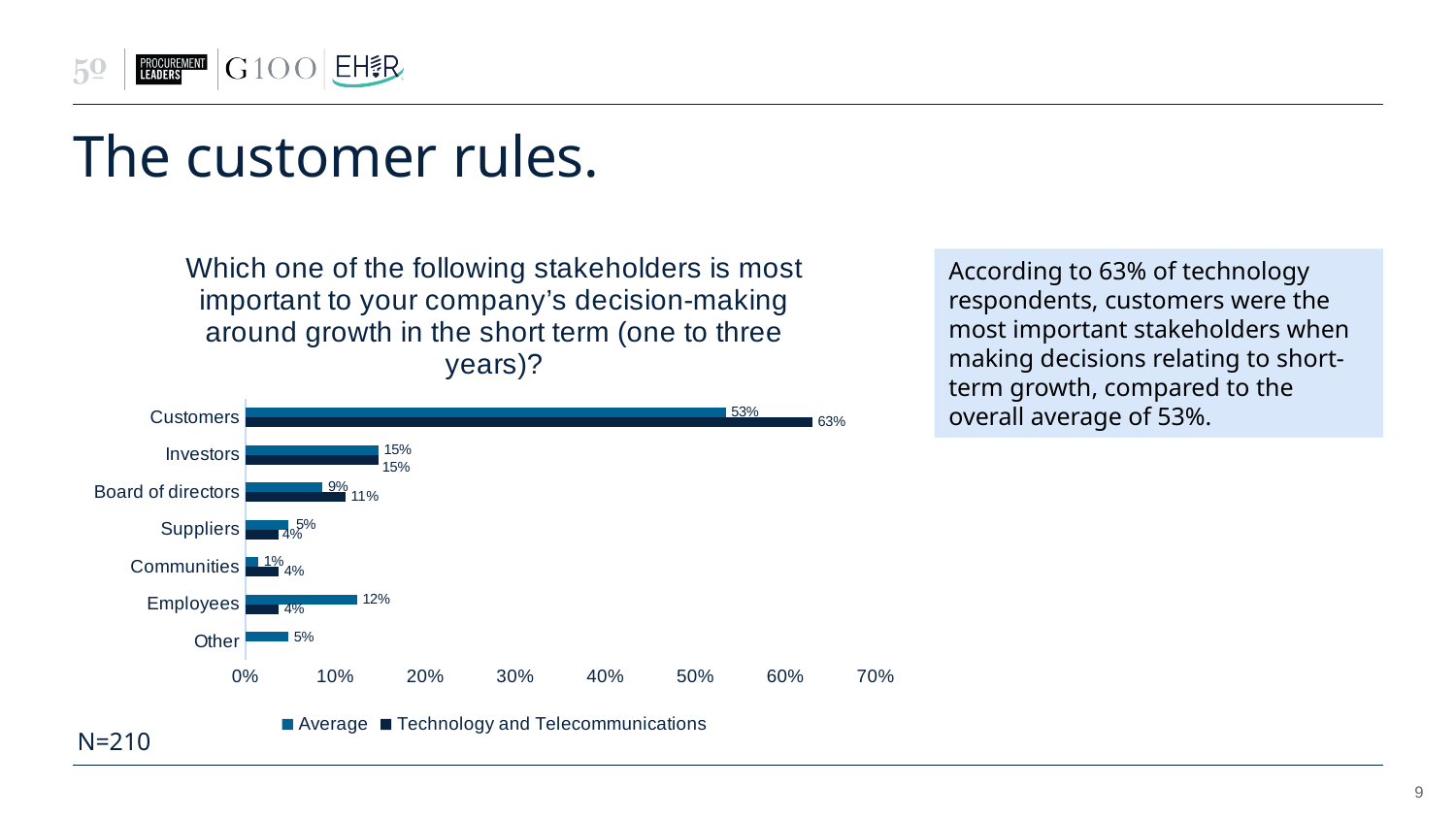
What is the difference between the Technology and Telecommunications value and the Average value for Customers? 10% What is the Average value for Employees? 12% Which stakeholder has the highest Average value? Customers For Employees, which is larger: the Average value or the Technology and Telecommunications value? Average Is the Technology and Telecommunications value for Customers greater or less than 60%? greater What is the Average value for Customers? 53% How many series does the legend list? 2 What is the Technology and Telecommunications value for Board of directors? 11% What is the Technology and Telecommunications value for Customers? 63% Which stakeholder has the lowest Average value? Communities How many stakeholder categories are shown on the chart? 7 What kind of chart is shown on the slide? Bar chart